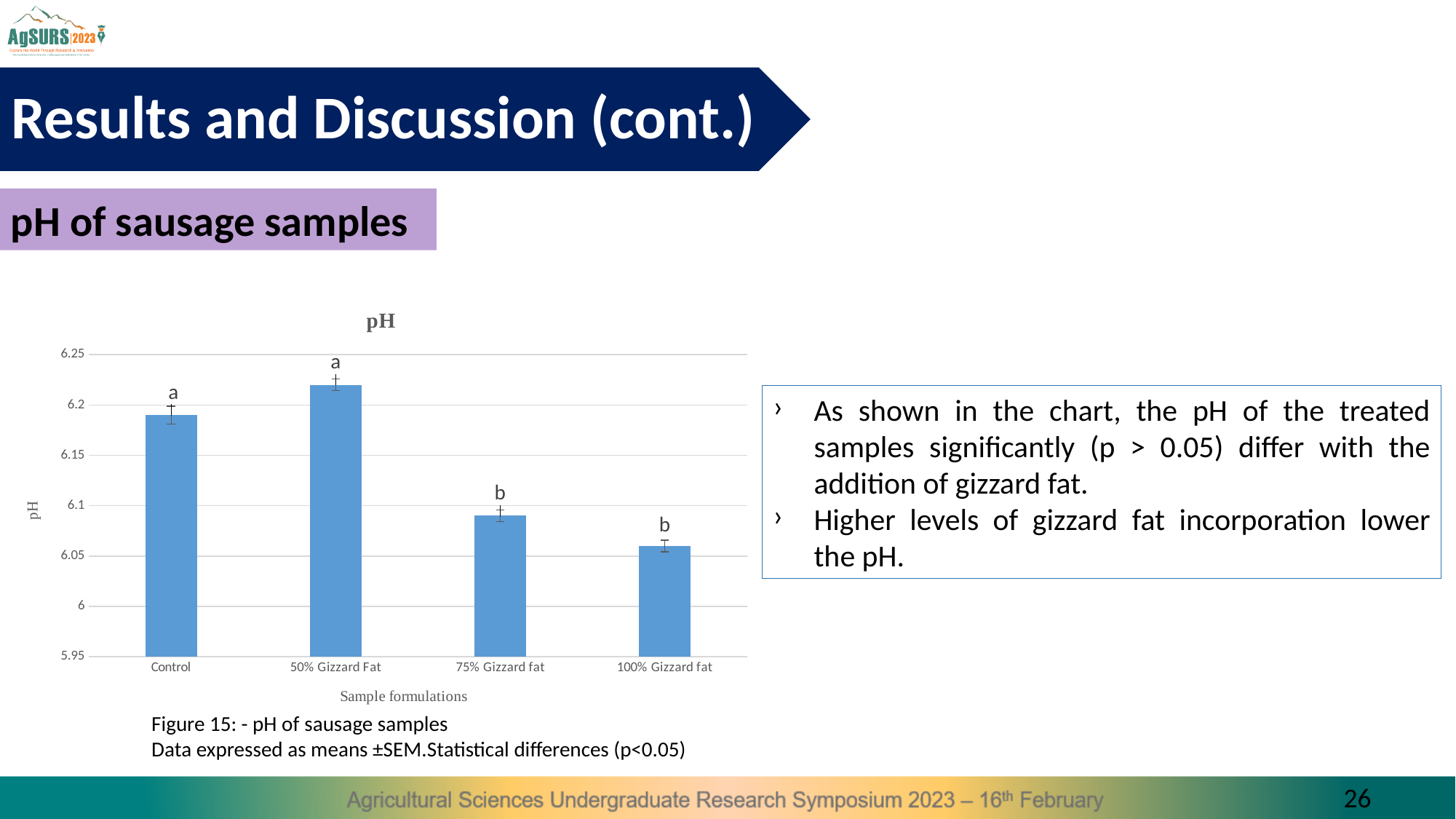
Is the pH value for 50% Gizzard Fat greater or less than 6.15? greater How many sample formulations are plotted in the chart? 4 What kind of chart is shown on the slide? bar chart Which has a higher pH, Control or 75% Gizzard fat? Control Is the pH value for 75% Gizzard fat greater or less than 6.05? greater Is the pH value for Control greater or less than 6.15? greater Does the pH rise or fall from 50% Gizzard Fat to 100% Gizzard fat? fall Which sample formulation has the lowest pH? 100% Gizzard fat Which sample formulation has the highest pH? 50% Gizzard Fat What is the title of the chart? pH Which has a higher pH, 50% Gizzard Fat or 100% Gizzard fat? 50% Gizzard Fat